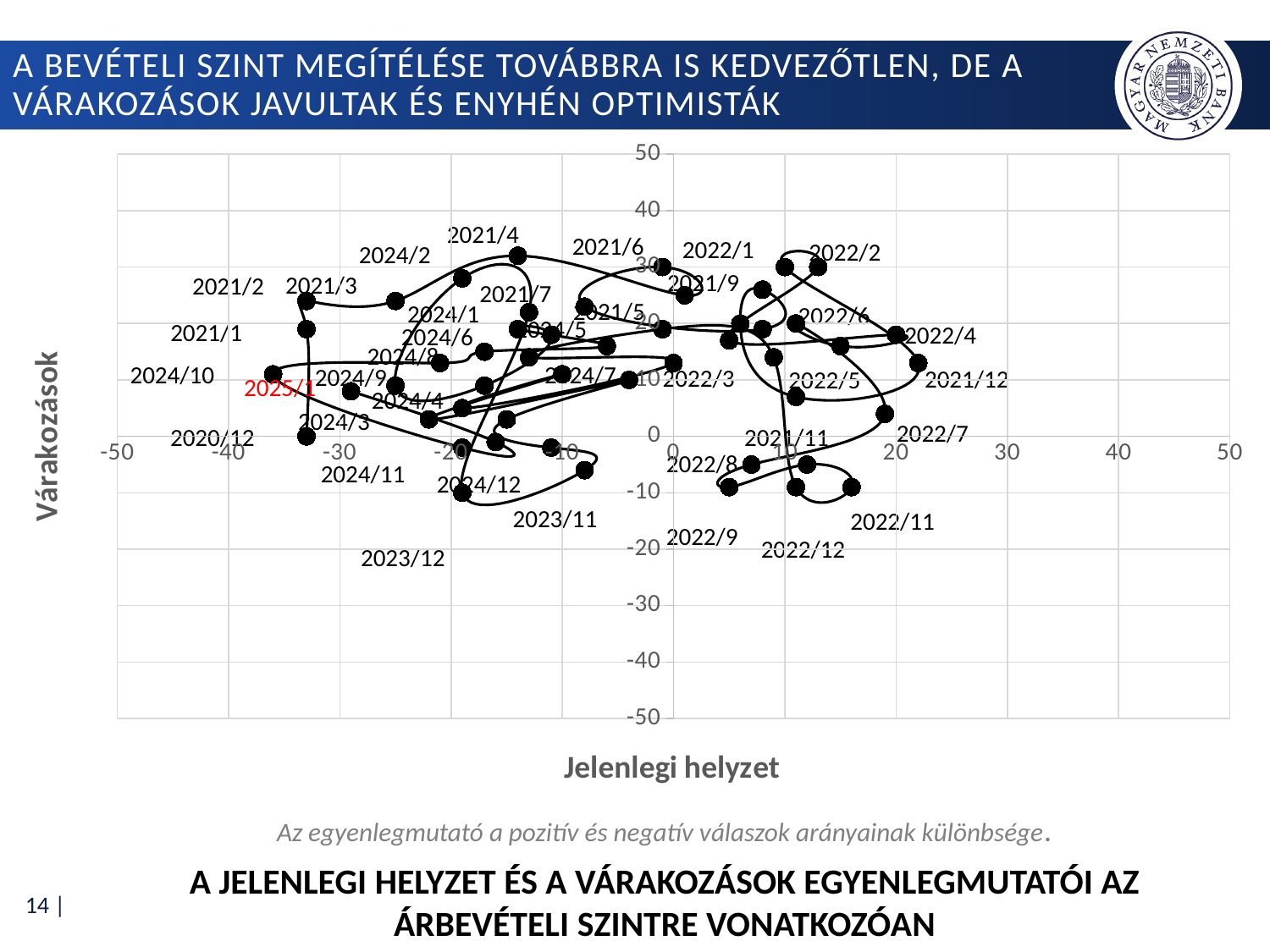
What is the title of the horizontal axis of the chart? Jelenlegi helyzet Which point has the larger Jelenlegi helyzet (horizontal axis) value, 2025/1 or 2022/2? 2022/2 Is the Jelenlegi helyzet (horizontal axis) value for the 2022/2 point greater or less than 0? greater Is the Várakozások (vertical axis) value for the 2025/1 point greater or less than 0? greater What kind of chart is shown on the slide? scatter chart Is the Várakozások (vertical axis) value for the 2021/4 point greater or less than 20? greater Which point has the larger Várakozások (vertical axis) value, 2021/4 or 2022/11? 2021/4 Which data point label on the chart is printed in red? 2025/1